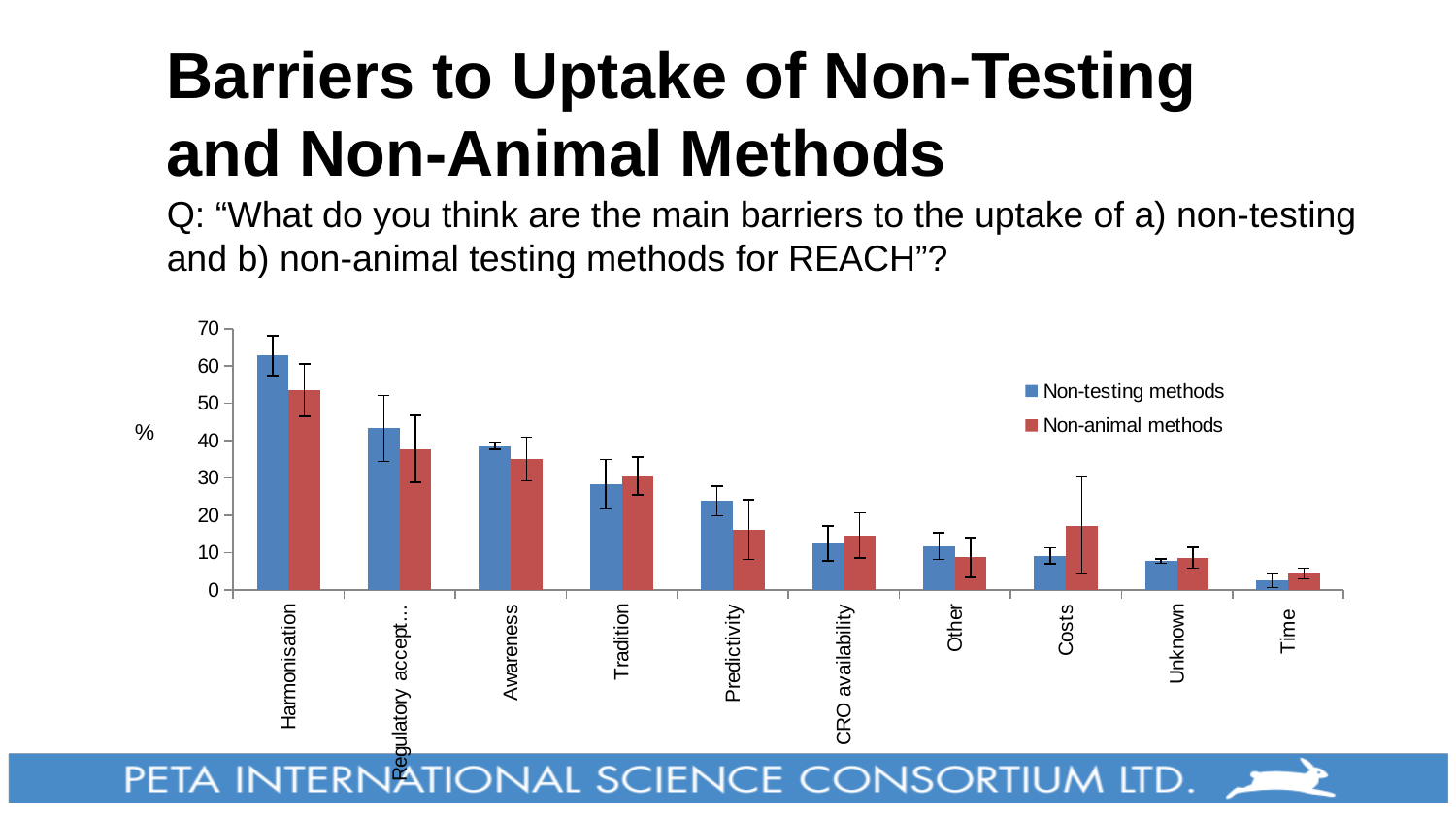
Do the Non-testing methods values generally rise or fall from left to right along the x axis? fall For Costs, which series has the larger value, Non-testing methods or Non-animal methods? Non-animal methods How many barrier categories are shown on the x axis? 10 Is the value for Awareness in the Non-testing methods series greater or less than 30? greater Which category has the highest value for Non-animal methods? Harmonisation What kind of chart is shown on the slide? bar chart Which category has the lowest value for Non-testing methods? Time For Harmonisation, which series has the larger value, Non-testing methods or Non-animal methods? Non-testing methods How many series does the legend list? 2 Is the value for Harmonisation in the Non-testing methods series greater or less than 50? greater Which category has the highest value for Non-testing methods? Harmonisation Is the value for Predictivity in the Non-animal methods series greater or less than 20? less